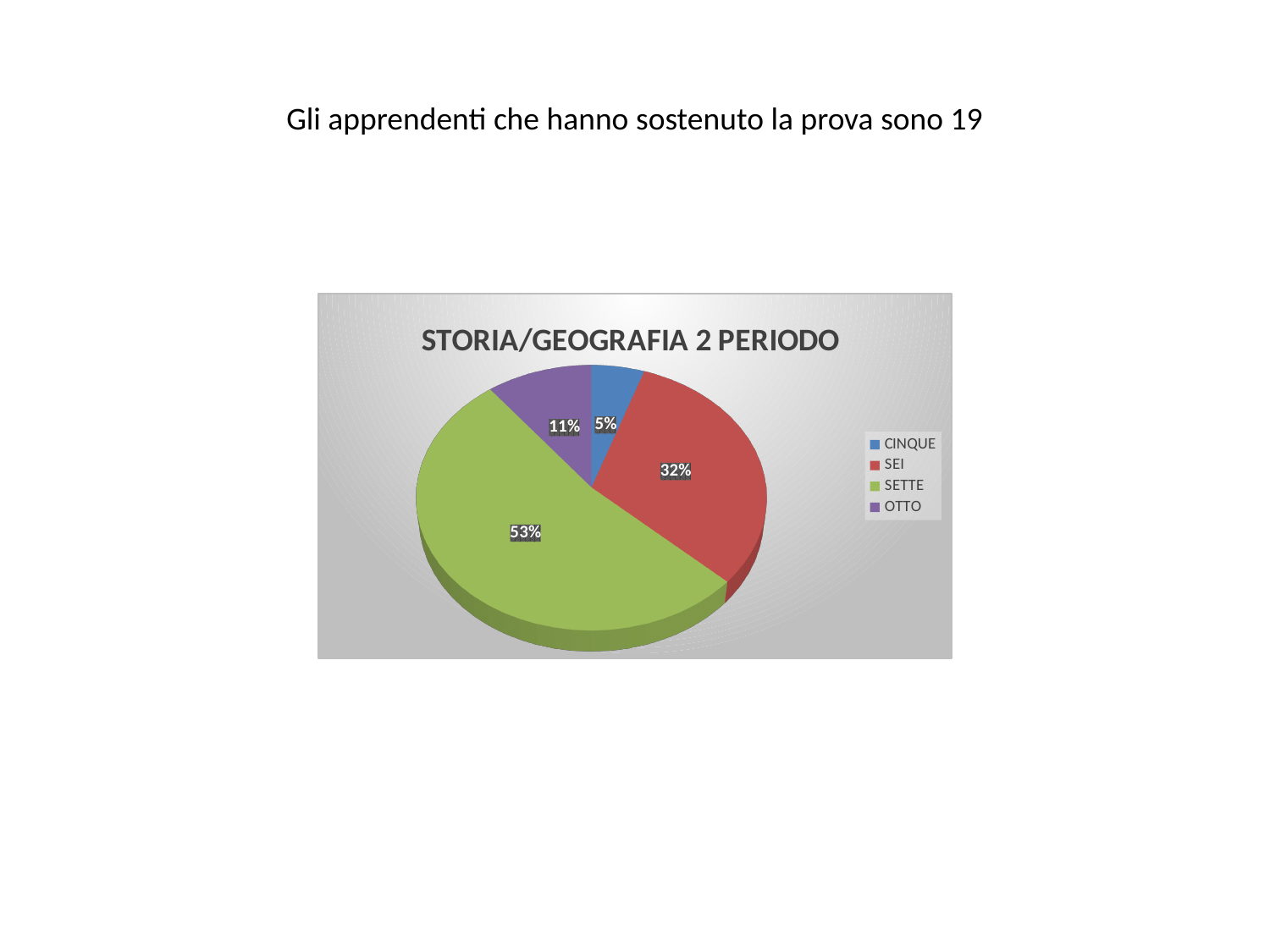
What percentage of the pie does the OTTO slice represent? 11% What is the title of the chart? STORIA/GEOGRAFIA 2 PERIODO What is the difference in percentage points between the SETTE slice and the SEI slice? 21 What percentage of the pie does the CINQUE slice represent? 5% Which slice is larger, SEI or OTTO? SEI What type of chart is shown on the slide? Pie chart How many categories does the legend list? 4 Which category has the largest slice of the pie? SETTE What percentage of the pie does the SETTE slice represent? 53% Which category has the smallest slice of the pie? CINQUE What colour is the SETTE slice? Green